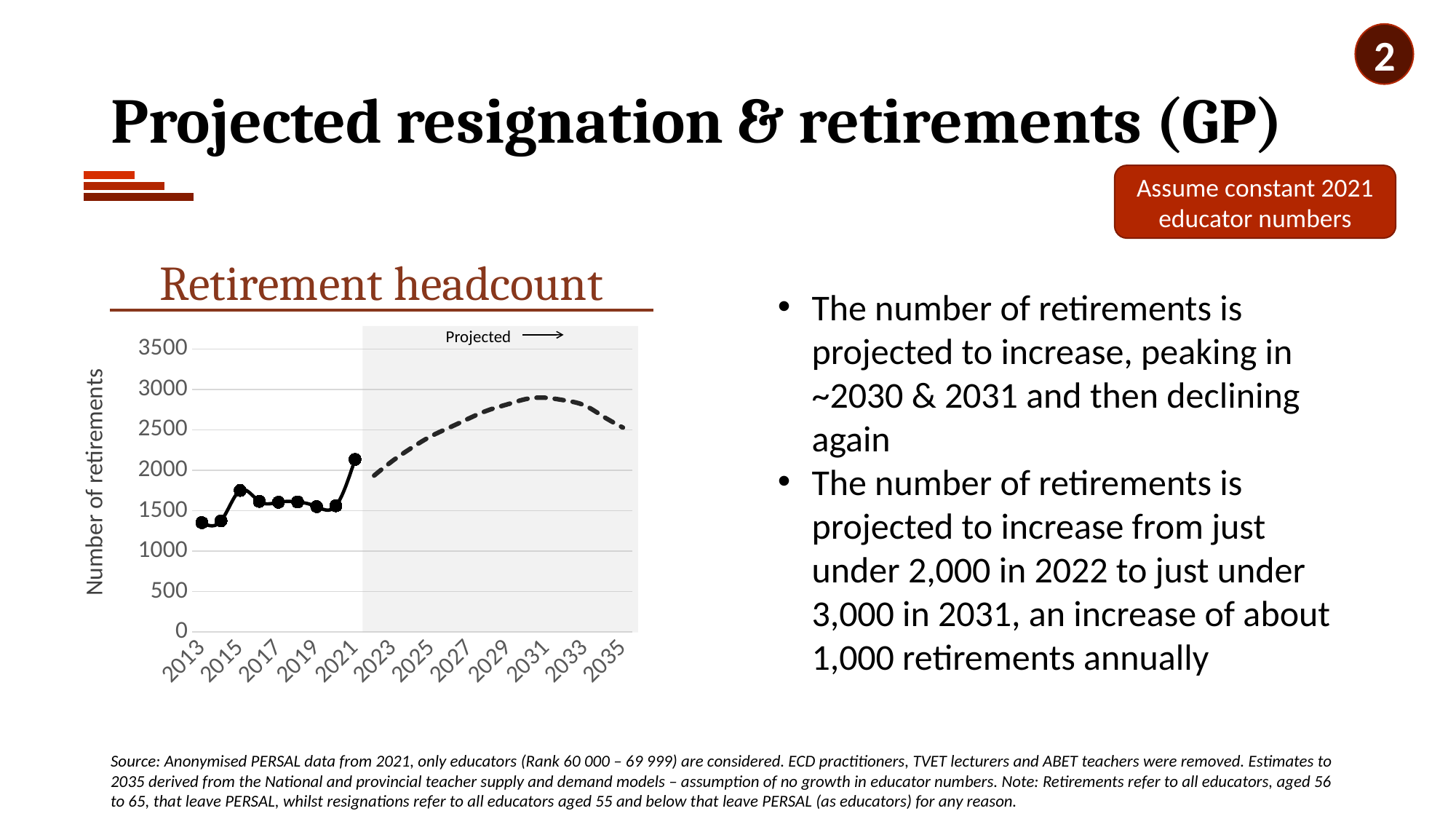
What is the title of the chart on the slide? Retirement headcount Is the value for 2013 greater or less than 1500? less Is the value for 2021 greater or less than 2000? greater Which year has the larger number of retirements, 2013 or 2021? 2021 Does the projected line rise or fall between 2031 and 2035? fall Which year has the larger projected number of retirements, 2023 or 2031? 2031 How many solid (non-projected) data points are plotted on the chart? 9 What is the label on the vertical axis of the chart? Number of retirements Is the projected value for 2027 greater or less than 2500? greater What kind of chart is shown under the title 'Retirement headcount'? line chart